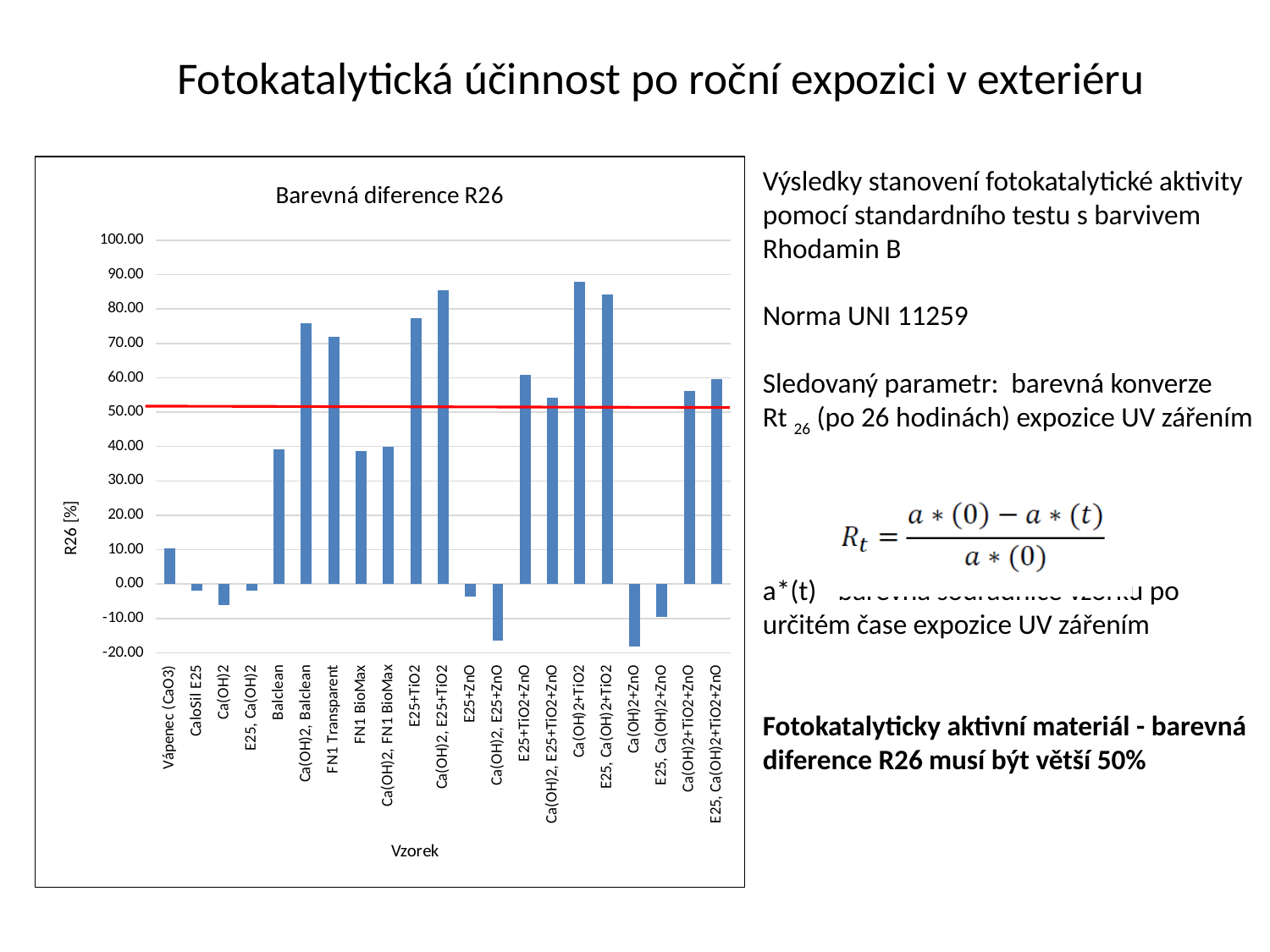
How many categories (samples) are plotted on the x axis of the chart? 21 Is the value for Ca(OH)2, E25+TiO2 greater or less than 80? greater Is the value for Vápenec (CaO3) greater or less than 20? less What kind of chart is shown on the slide? bar chart Which has the larger value, E25+TiO2+ZnO or Ca(OH)2, E25+TiO2+ZnO? E25+TiO2+ZnO What is the title of the chart? Barevná diference R26 Is the value for Ca(OH)2, Balclean greater or less than 70? greater What is the label of the vertical axis of the chart? R26 [%] Which has the larger value, Ca(OH)2, Balclean or FN1 BioMax? Ca(OH)2, Balclean